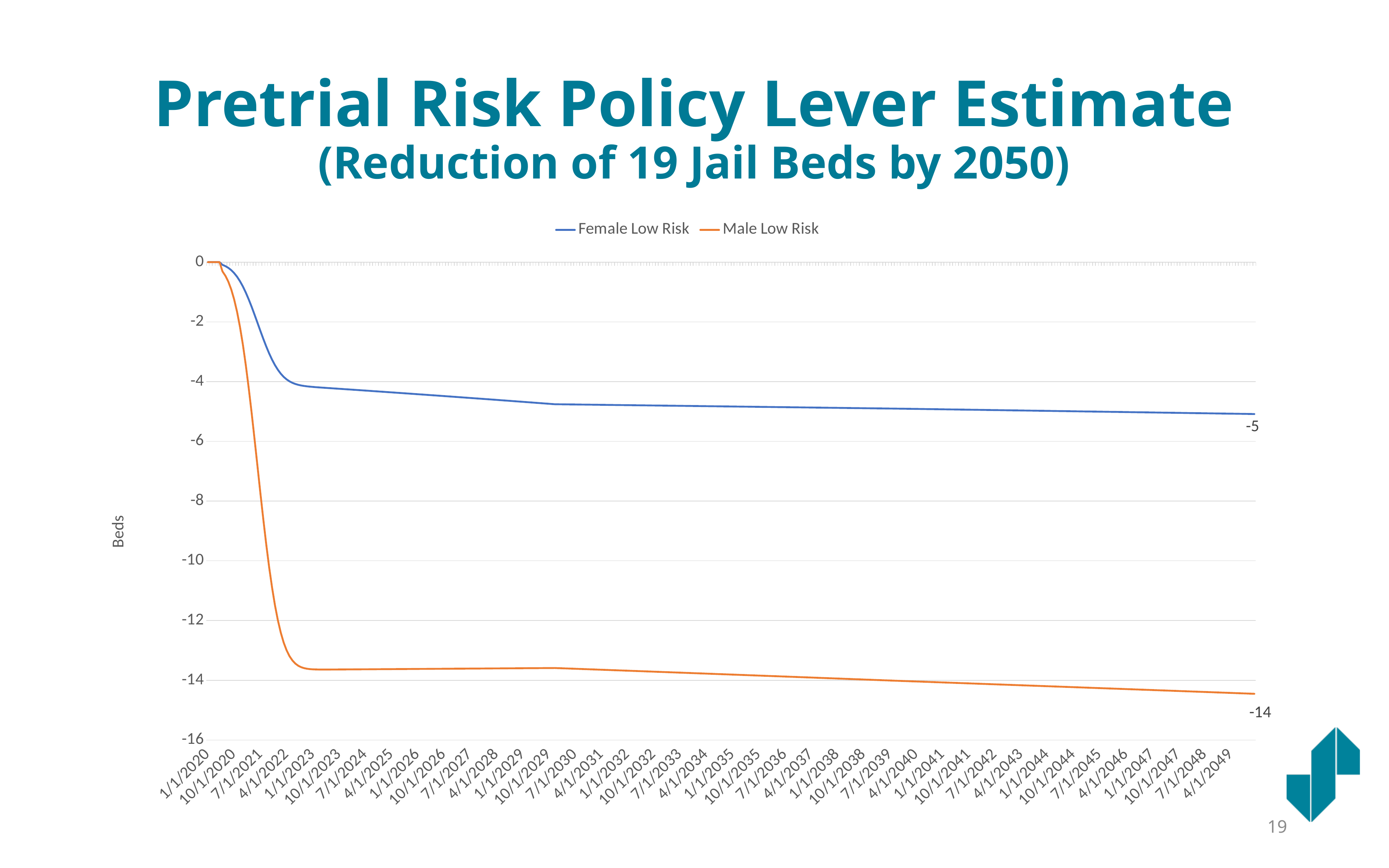
Which series ends at a lower value, Female Low Risk or Male Low Risk? Male Low Risk What is the title of the vertical axis? Beds What value do both series start at on 1/1/2020? 0 Do the values of the Male Low Risk series rise or fall along the x axis? fall What is the difference between the final labelled values of the Female Low Risk and Male Low Risk series? 9 Is the value for Female Low Risk at 1/1/2030 greater or less than -6? greater What is the subtitle shown under the chart's main title? (Reduction of 19 Jail Beds by 2050) What is the final labelled value for the Female Low Risk series? -5 What is the final labelled value for the Male Low Risk series? -14 How many series does the legend list? 2 What kind of chart is shown on the slide? line chart Is the value for Male Low Risk at 1/1/2030 greater or less than -12? less